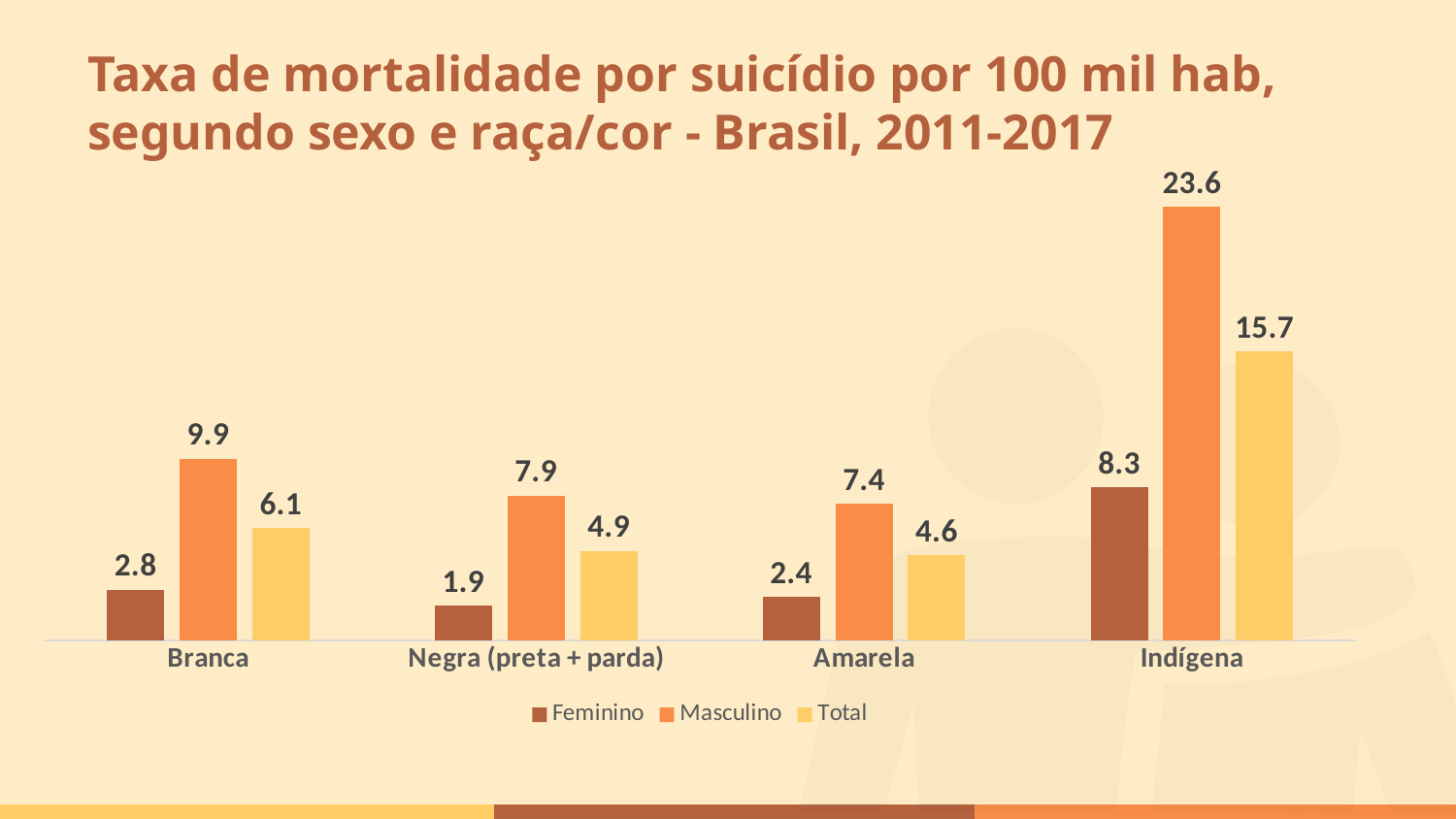
How many categories are shown on the x axis? 4 Which category has the lowest Feminino value? Negra (preta + parda) What is the Feminino value for Negra (preta + parda)? 1.9 What is the Masculino value for Indígena? 23.6 What is the difference between the Masculino and Feminino values for Indígena? 15.3 What is the difference between the Masculino values for Branca and Amarela? 2.5 What kind of chart is shown on the slide? Bar chart Which is larger, the Total value for Branca or the Total value for Amarela? Branca What is the Total value for Branca? 6.1 What are the three series listed in the legend? Feminino, Masculino, Total Which category has the highest Masculino value? Indígena How many series does the legend list? 3